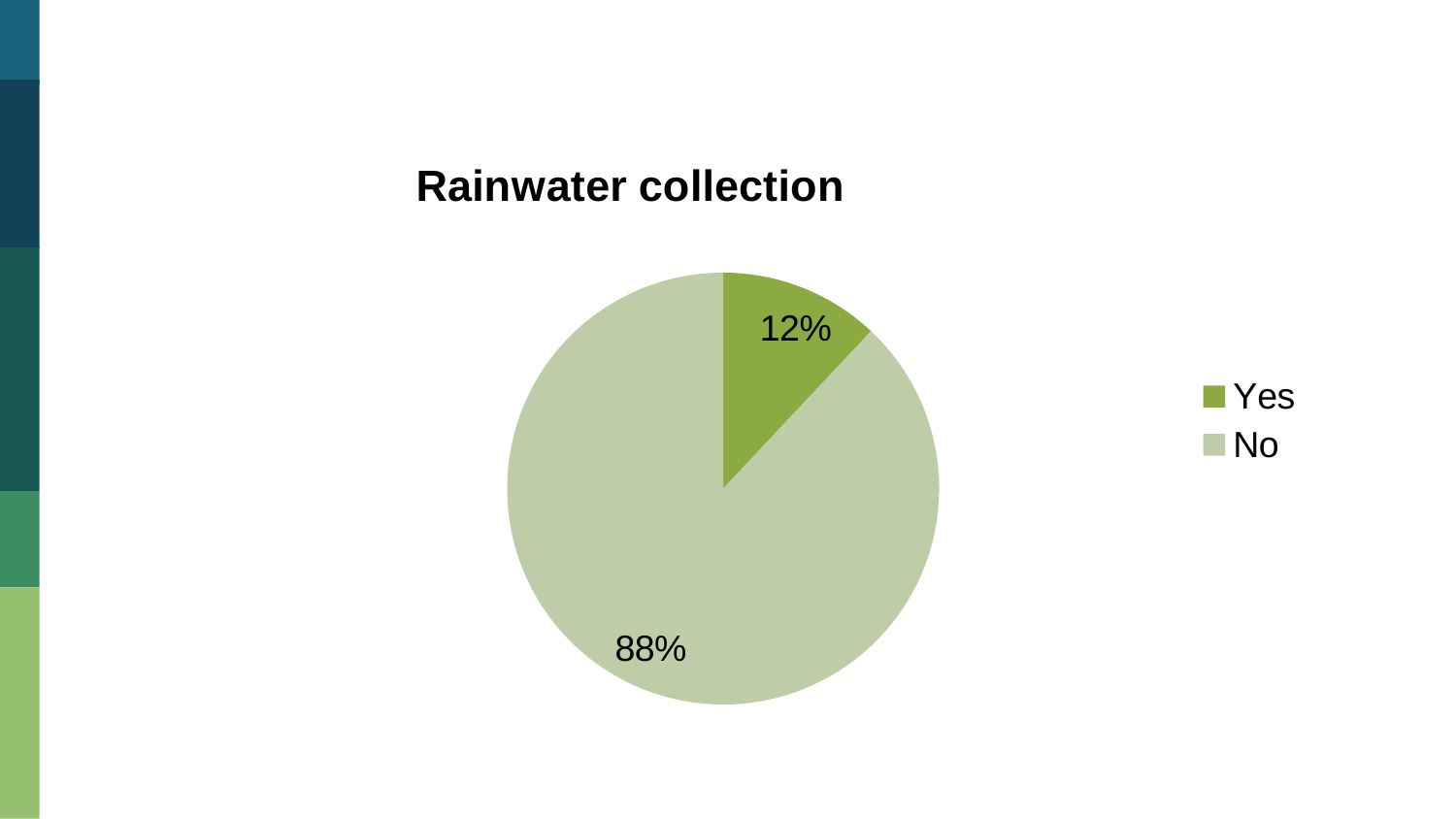
What share of the pie does the "No" slice represent? 88% Which category has the largest slice of the pie? No What share of the pie does the "Yes" slice represent? 12% How many slices does the pie chart have? 2 Which legend entry is shown in the darker green colour? Yes Which category has the smallest slice of the pie? Yes How many categories does the legend list? 2 What is the difference in percentage points between the "No" and "Yes" slices? 76 What is the title of the chart? Rainwater collection What kind of chart is shown on the slide? pie chart Which is larger, the "Yes" slice or the "No" slice? No